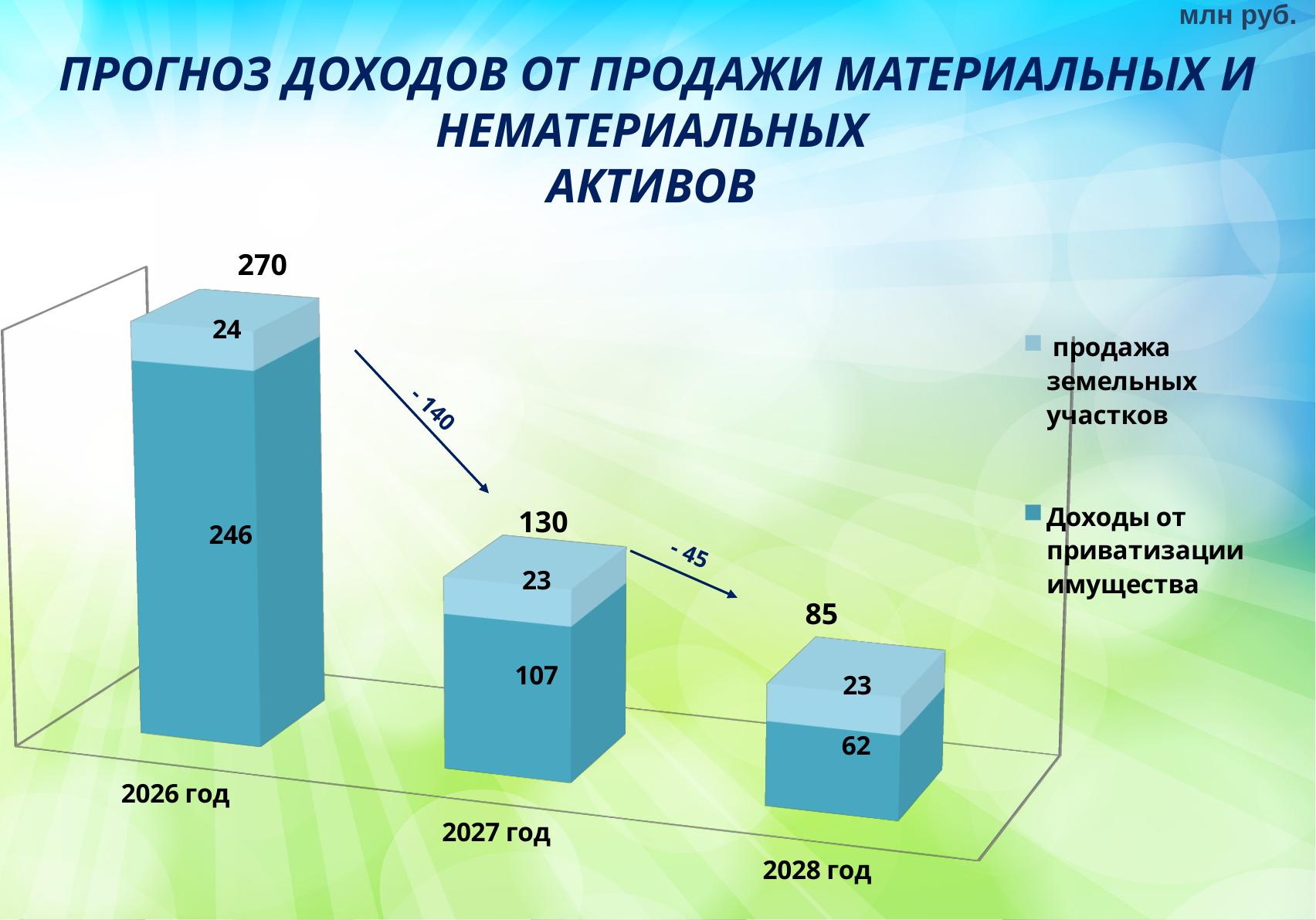
Which year has the lowest value for "Доходы от приватизации имущества"? 2028 год Which is larger: "Доходы от приватизации имущества" in 2027 год or in 2028 год? 2027 год Do the totals rise or fall from 2026 год to 2028 год? fall What is the value for "Доходы от приватизации имущества" in 2028 год? 62 What is the total of the stacked bar for 2028 год? 85 What is the value for "Доходы от приватизации имущества" in 2026 год? 246 Which year has the highest total? 2026 год What is the difference between the totals for 2026 год and 2027 год? 140 How many series does the legend list? 2 How many years are shown on the x axis? 3 What is the total of the stacked bar for 2027 год? 130 What is the value for "продажа земельных участков" in 2027 год? 23